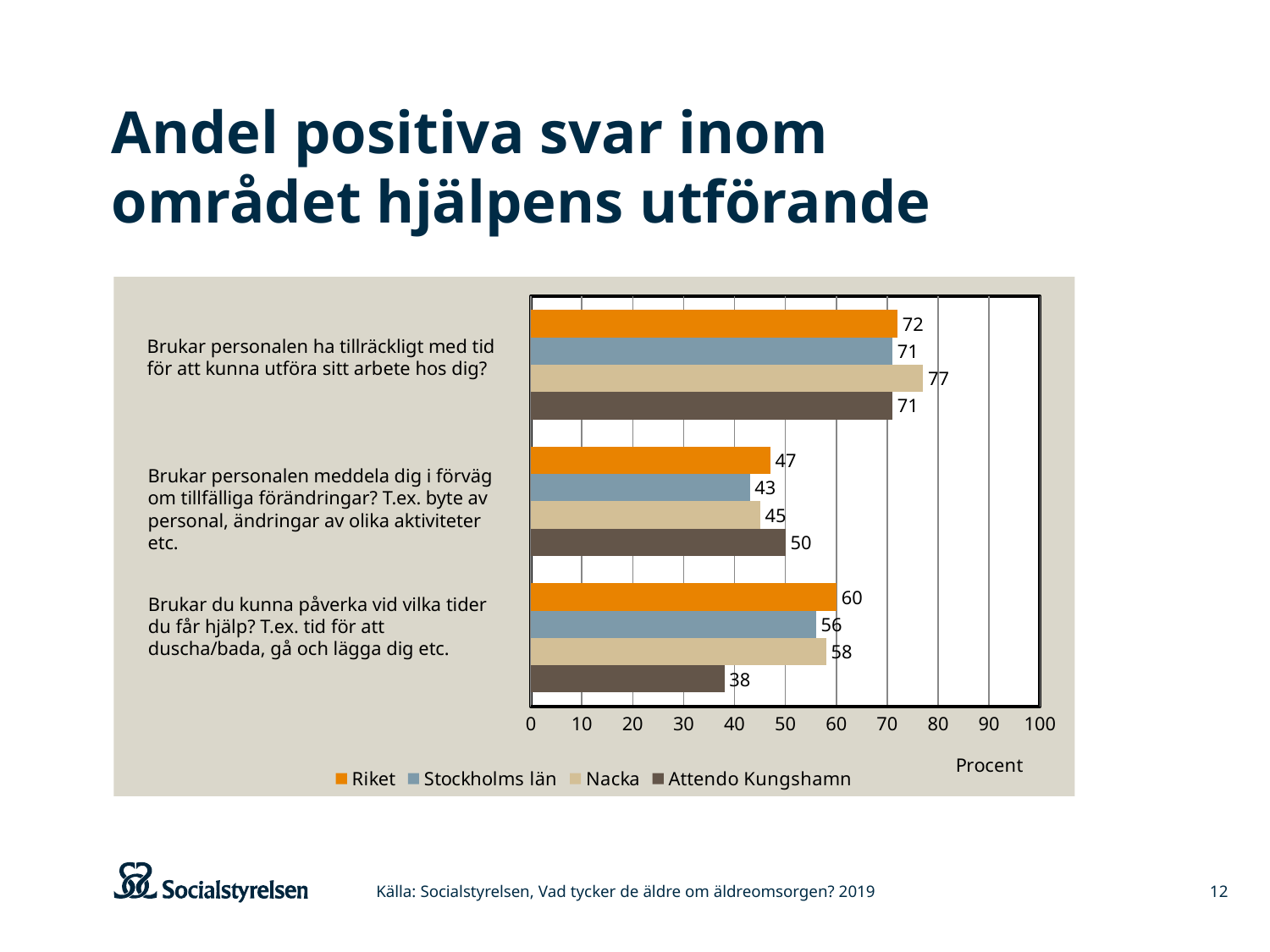
How many series does the legend list? 4 What is the label on the horizontal axis of the chart? Procent What is the value for Nacka on the question "Brukar personalen ha tillräckligt med tid för att kunna utföra sitt arbete hos dig?" 77 Which is larger on the question "Brukar personalen meddela dig i förväg om tillfälliga förändringar?": Riket or Nacka? Riket What is the value for Stockholms län on the question "Brukar personalen meddela dig i förväg om tillfälliga förändringar?" 43 What is the value for Attendo Kungshamn on the question "Brukar du kunna påverka vid vilka tider du får hjälp?" 38 What kind of chart is shown on the slide? Bar chart How many questions (categories) are shown on the chart? 3 What is the difference between Nacka and Riket on the question "Brukar personalen ha tillräckligt med tid för att kunna utföra sitt arbete hos dig?" 5 Which series has the lowest value on the question "Brukar du kunna påverka vid vilka tider du får hjälp?" Attendo Kungshamn Which series has the highest value on the question "Brukar personalen meddela dig i förväg om tillfälliga förändringar?" Attendo Kungshamn What is the difference between Riket and Attendo Kungshamn on the question "Brukar du kunna påverka vid vilka tider du får hjälp?" 22